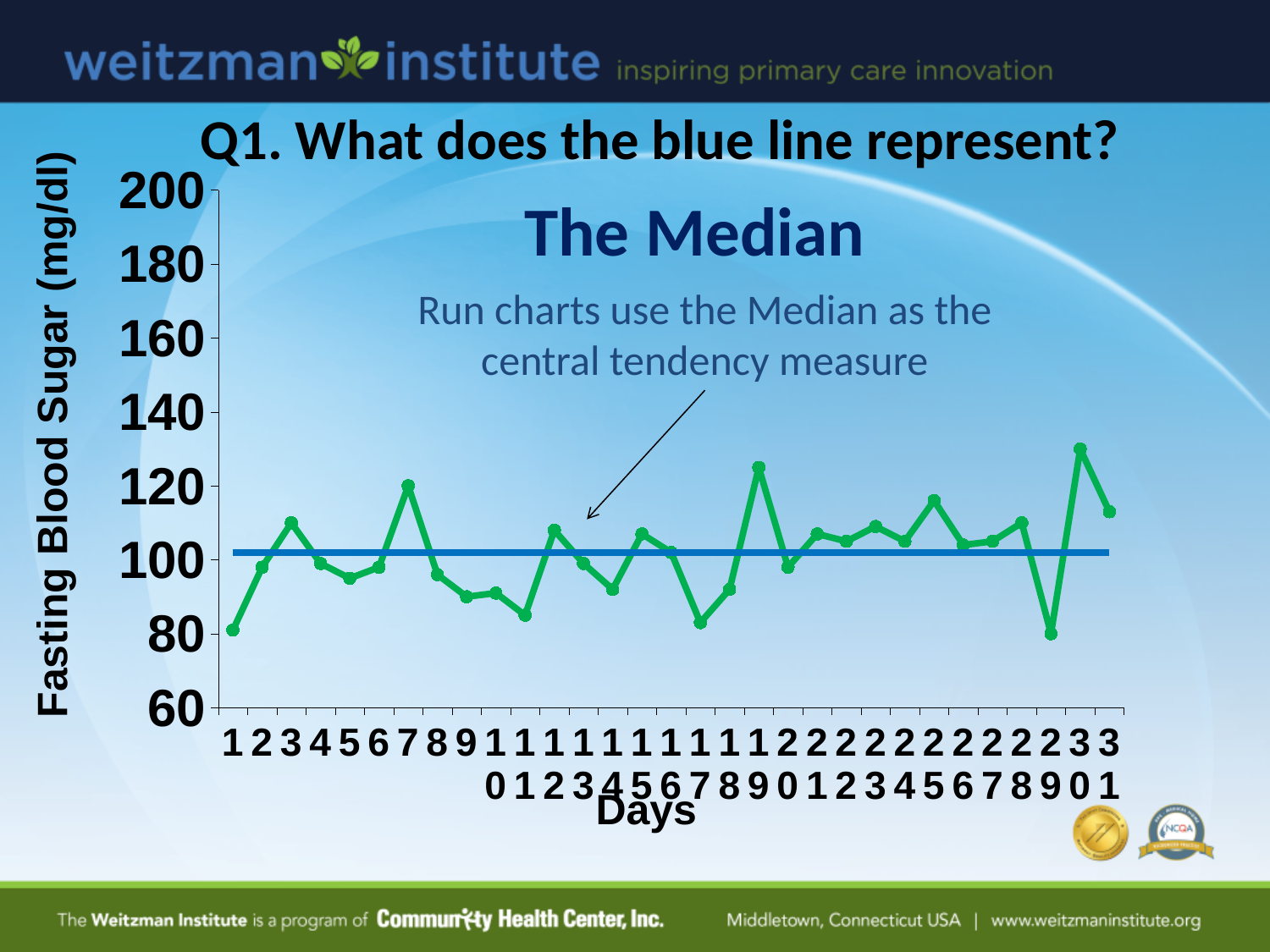
Is the value for day 1 greater or less than 100? less Is the value for day 30 greater or less than 120? greater Which has the larger value, day 17 or day 19? day 19 Is the value for day 17 greater or less than 100? less How many days (data points) are plotted on the x axis? 31 What kind of chart is shown on the slide? line chart Which has the larger value, day 7 or day 1? day 7 What is the label of the y axis? Fasting Blood Sugar (mg/dl) Which day has the highest fasting blood sugar value? 30 What does the blue horizontal line on the chart represent? The Median